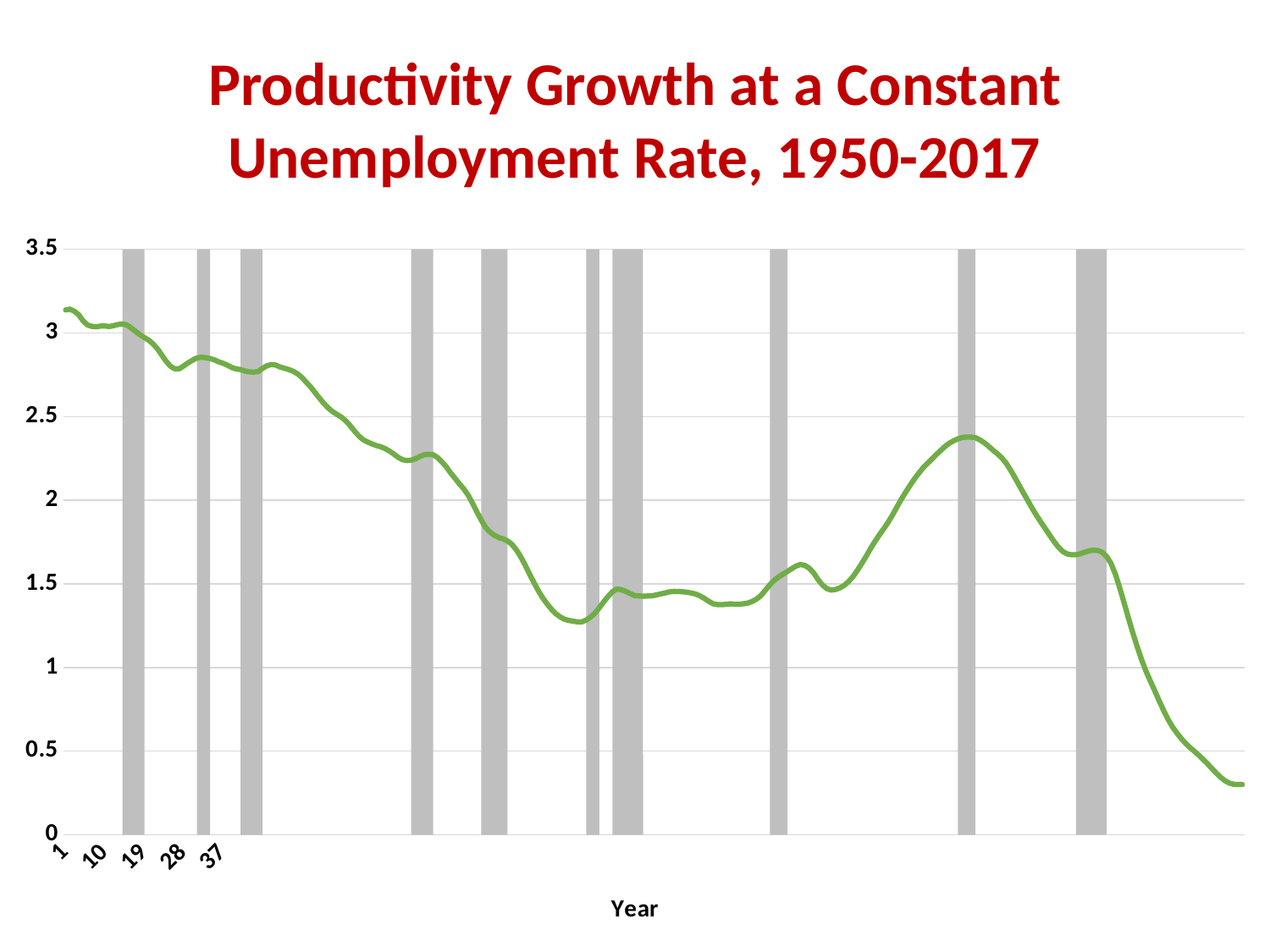
Is the peak of the line in the right half of the chart greater or less than 2.5? less Overall, does the plotted line rise or fall from left to right across the chart? Fall Is the value at the left end of the line (x = 1) greater or less than 3? greater Is the value at the left end of the line (x = 1) larger or smaller than the value at the right end of the line? larger What is the title of the chart? Productivity Growth at a Constant Unemployment Rate, 1950-2017 What is the label on the x axis of the chart? Year Is the lowest point of the line in the middle of the chart (around the dip before the gray bands near the centre) greater or less than 1.5? less What type of chart is shown on the slide? Line chart How many lines are plotted on the chart? 1